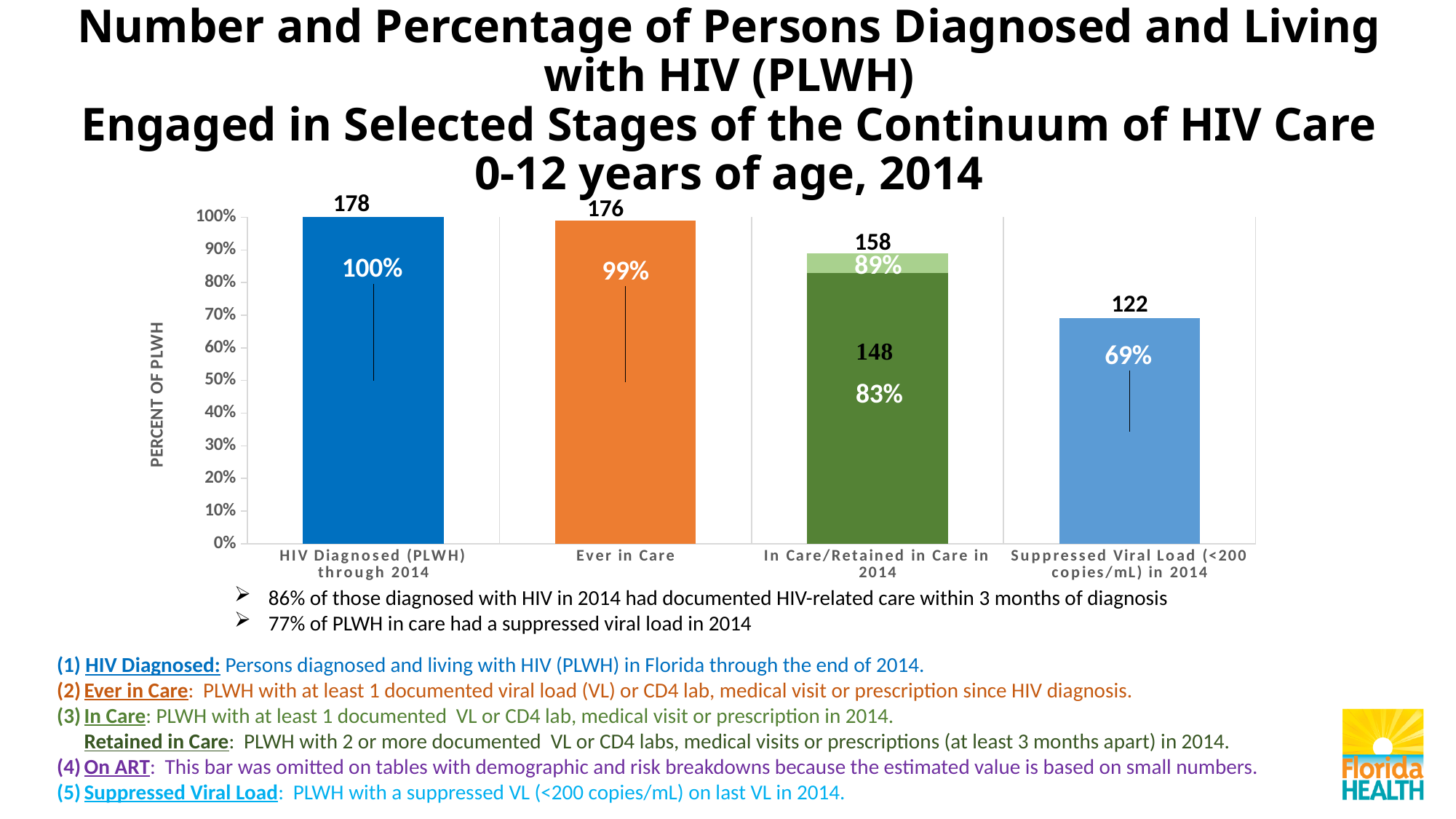
Do the percentages rise or fall moving from left to right across the categories? Fall What is the difference in number of persons between HIV Diagnosed (PLWH) through 2014 and Suppressed Viral Load (<200 copies/mL) in 2014? 56 What percentage is shown for Retained in Care (the darker green portion) in the In Care/Retained in Care in 2014 bar? 83% What percentage is shown on the Ever in Care bar? 99% How many categories are shown on the x axis of the chart? 4 What number is printed above the In Care/Retained in Care in 2014 bar? 158 What number is printed above the Suppressed Viral Load (<200 copies/mL) in 2014 bar? 122 Which category has the lowest percentage of PLWH? Suppressed Viral Load (<200 copies/mL) in 2014 Which category has the highest percentage of PLWH? HIV Diagnosed (PLWH) through 2014 Which is larger, the percentage for Ever in Care or the percentage for Suppressed Viral Load (<200 copies/mL) in 2014? Ever in Care What number is printed above the bar for HIV Diagnosed (PLWH) through 2014? 178 What kind of chart is shown on the slide? Bar chart